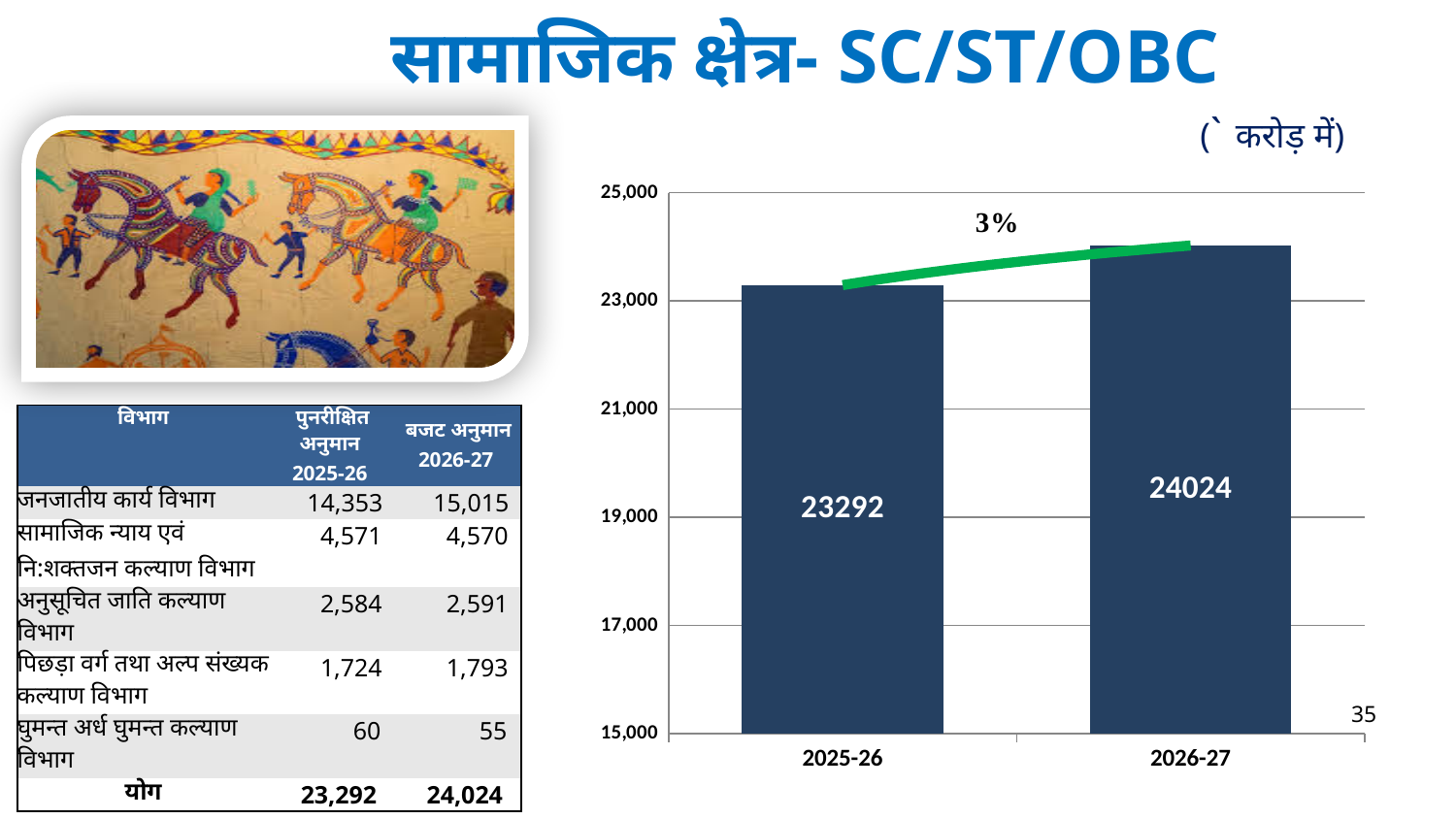
What kind of chart is shown on the slide? bar chart Which year has the higher bar? 2026-27 What is the value of the bar for 2025-26? 23292 Do the values rise or fall from 2025-26 to 2026-27? rise Is the value for 2026-27 greater or less than 25,000? less Which year has the lower bar? 2025-26 What is the value of the bar for 2026-27? 24024 What is the difference between the 2026-27 value and the 2025-26 value? 732 Is the value for 2026-27 larger or smaller than the value for 2025-26? larger How many bars are plotted in the chart? 2 Is the value for 2025-26 greater or less than 23,000? greater What percentage change is annotated above the bars in the chart? 3%